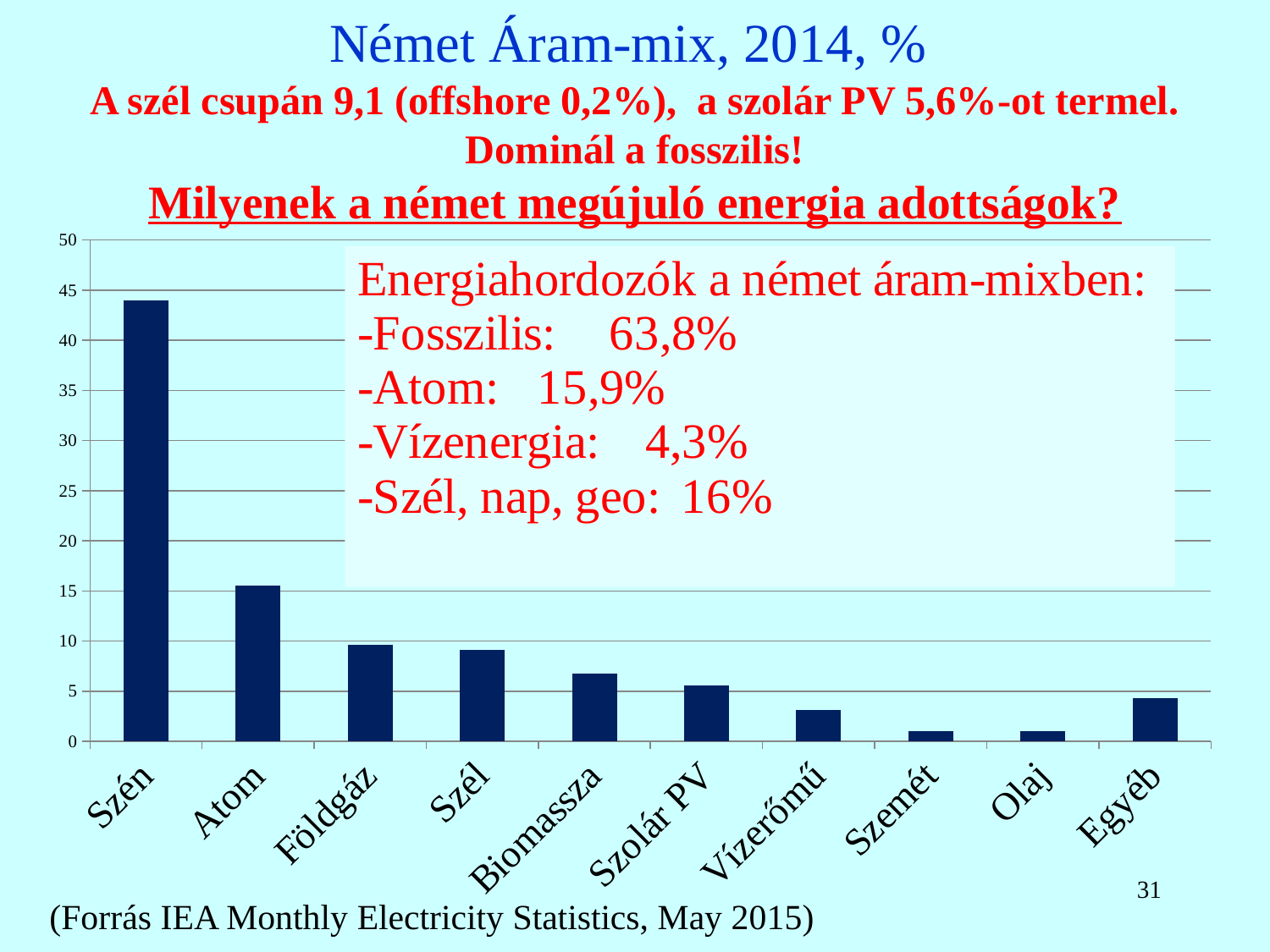
What kind of chart is shown on the slide? bar chart Is the value for Szén greater or less than 40? greater What is the title of the chart on the slide? Német Áram-mix, 2014, % Is the value for Földgáz greater or less than 15? less Is the value for Szemét greater or less than 5? less Which category has the highest bar in the chart? Szén Which is larger, the value for Szén or the value for Atom? Szén Which is larger, the value for Atom or the value for Földgáz? Atom How many categories are shown on the x axis of the chart? 10 Which is larger, the value for Egyéb or the value for Vízerőmű? Egyéb